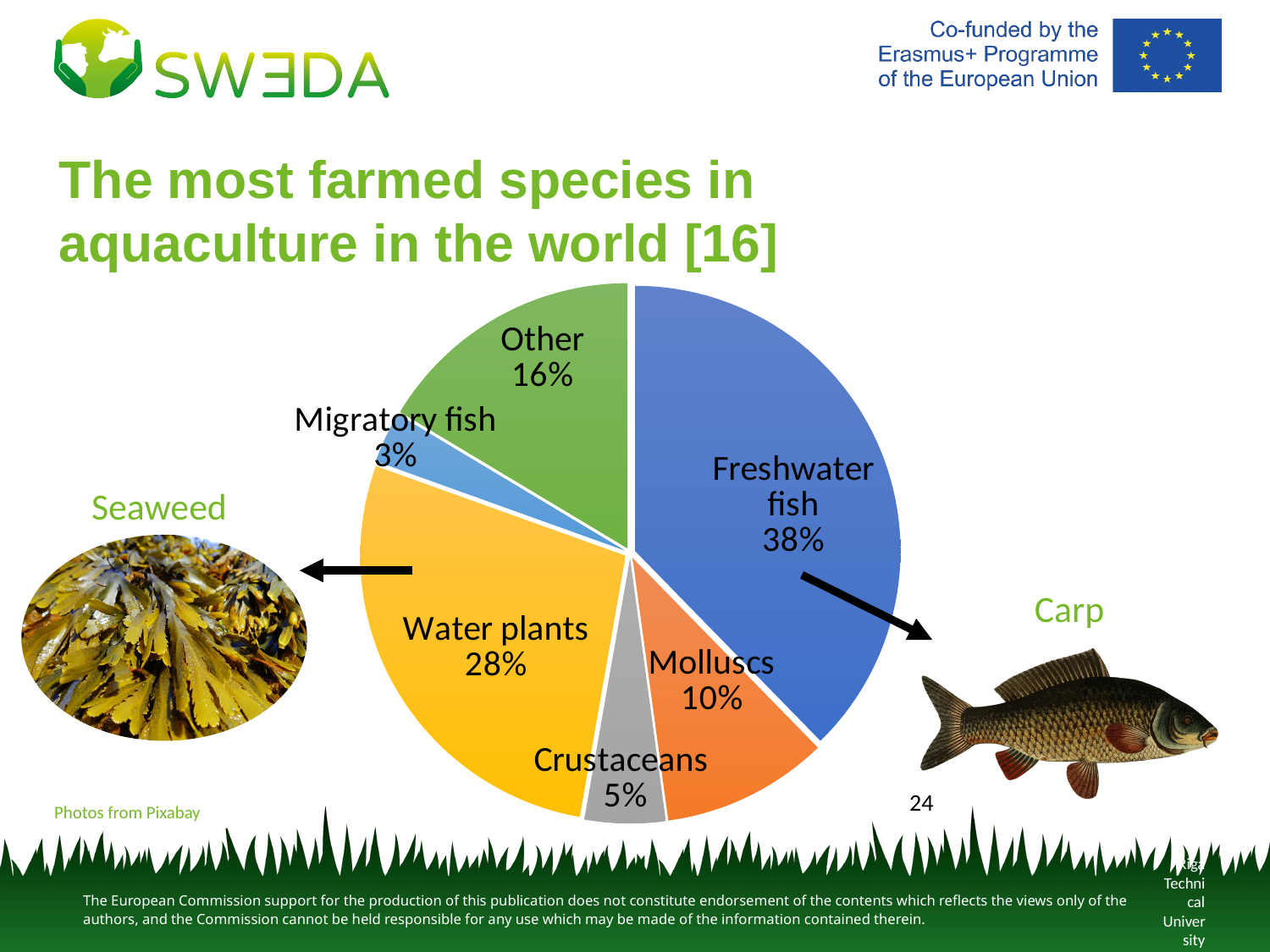
What percentage is shown for Molluscs? 10% What share of the pie does Freshwater fish hold? 38% What type of chart is shown on the slide? Pie chart What is the title of the slide containing the chart? The most farmed species in aquaculture in the world [16] Which is larger, the share for Molluscs or the share for Crustaceans? Molluscs How many categories are shown in the pie chart? 6 Which category has the largest slice of the pie? Freshwater fish What is the difference in percentage points between Other and Crustaceans? 11 What percentage is shown for Migratory fish? 3% What is the difference in percentage points between Freshwater fish and Water plants? 10 What share of the pie does Water plants hold? 28% Which category has the smallest slice of the pie? Migratory fish